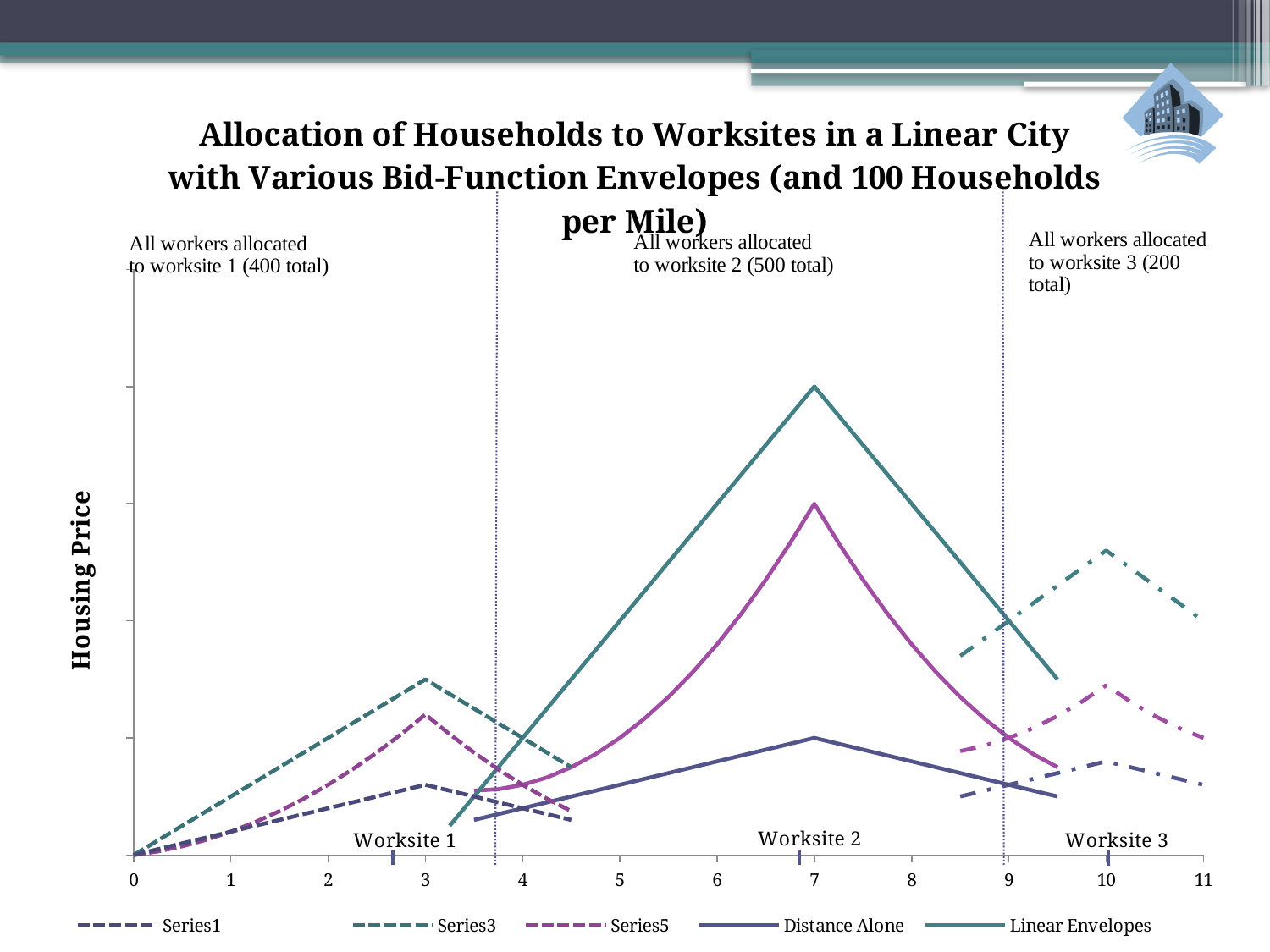
Does the Linear Envelopes line rise or fall between x = 4 and x = 7? rise At x = 3, which is higher: the Series3 line or the Series1 line? Series3 How many series does the legend list? 5 How many worksites are marked along the horizontal axis? 3 What is the label on the vertical axis? Housing Price What kind of chart is shown on the slide? line chart Does the Series3 line rise or fall between x = 3 and x = 4? fall Which series reaches the highest housing price on the chart? Linear Envelopes What is the highest value shown on the horizontal axis? 11